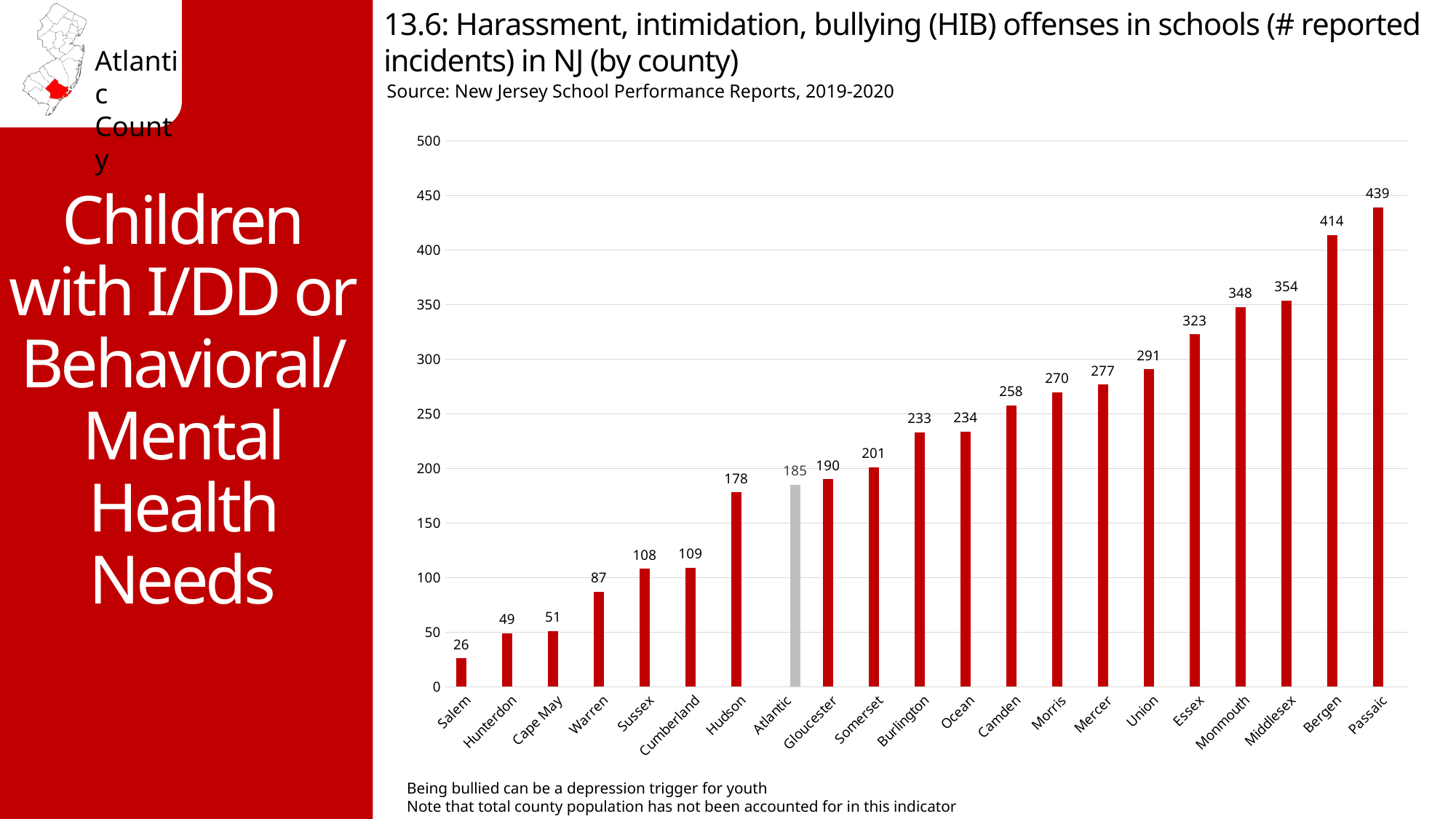
Which county has the highest number of reported HIB incidents? Passaic What is the number of reported HIB incidents for Atlantic County? 185 Do the values rise or fall moving from left to right along the x axis? Rise Is the value for Union greater or less than 300? less What is the number of reported HIB incidents for Hudson? 178 Which county has the lowest number of reported HIB incidents? Salem What is the difference in reported HIB incidents between Atlantic and Salem? 159 Which county has more reported HIB incidents, Essex or Monmouth? Monmouth How many counties are shown on the chart? 21 What is the difference in reported HIB incidents between Passaic and Bergen? 25 Which county's bar is coloured grey instead of red? Atlantic What kind of chart is shown on the slide? Bar chart